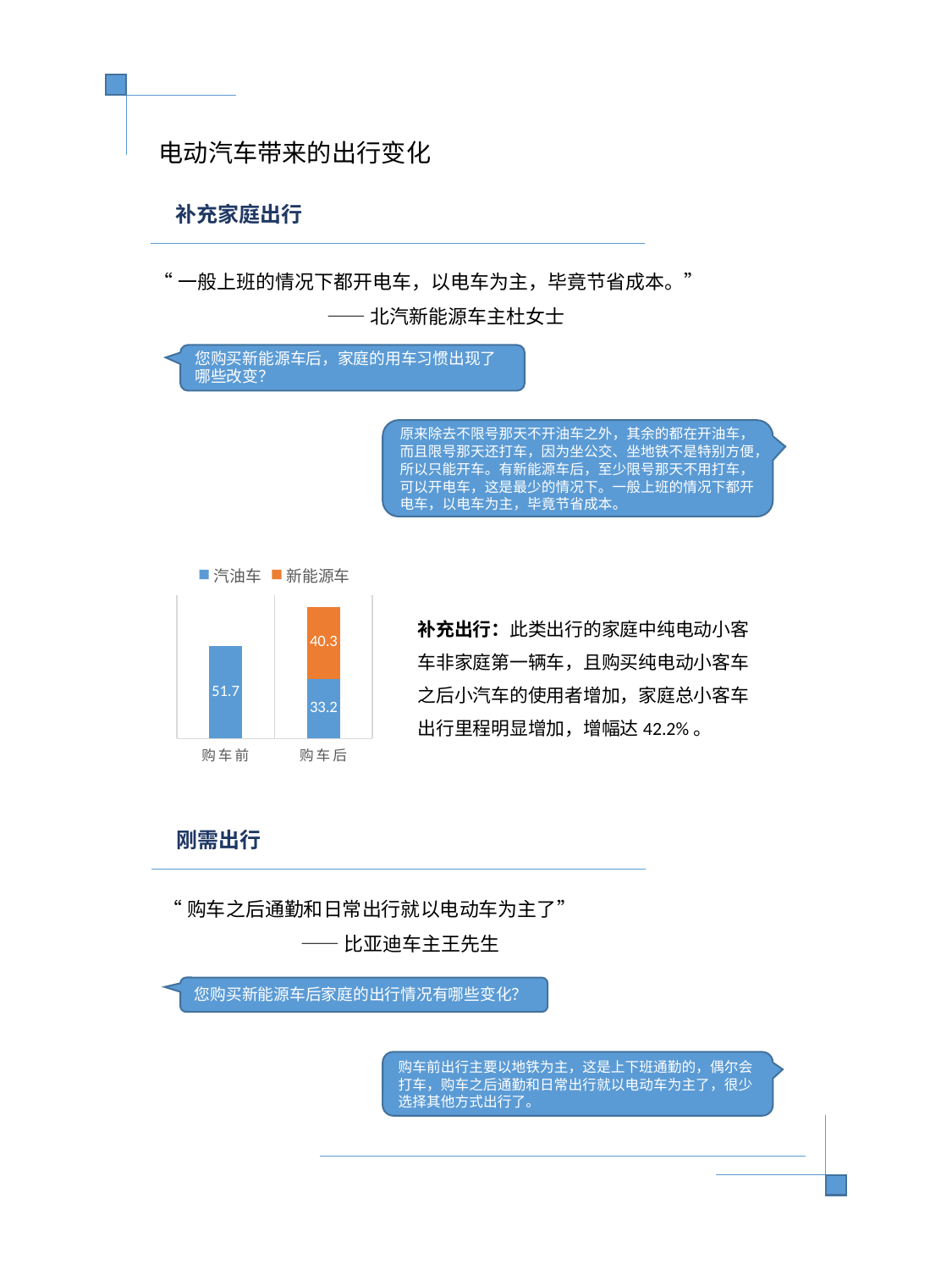
What is the difference between the 汽油车 value for 购车前 and the 汽油车 value for 购车后? 18.5 What is the value for 新能源车 in the 购车后 bar? 40.3 How many categories are shown on the x axis of the chart? 2 What is the value for 汽油车 in the 购车前 bar? 51.7 How many series does the chart legend list? 2 Which series is shown in orange in the chart? 新能源车 What is the value for 汽油车 in the 购车后 bar? 33.2 What is the total of the stacked 购车后 bar? 73.5 Which is larger in the 购车后 bar, 汽油车 or 新能源车? 新能源车 What kind of chart is shown on the slide? stacked bar chart Does the 汽油车 value rise or fall from 购车前 to 购车后? fall Which category has the higher 汽油车 value, 购车前 or 购车后? 购车前